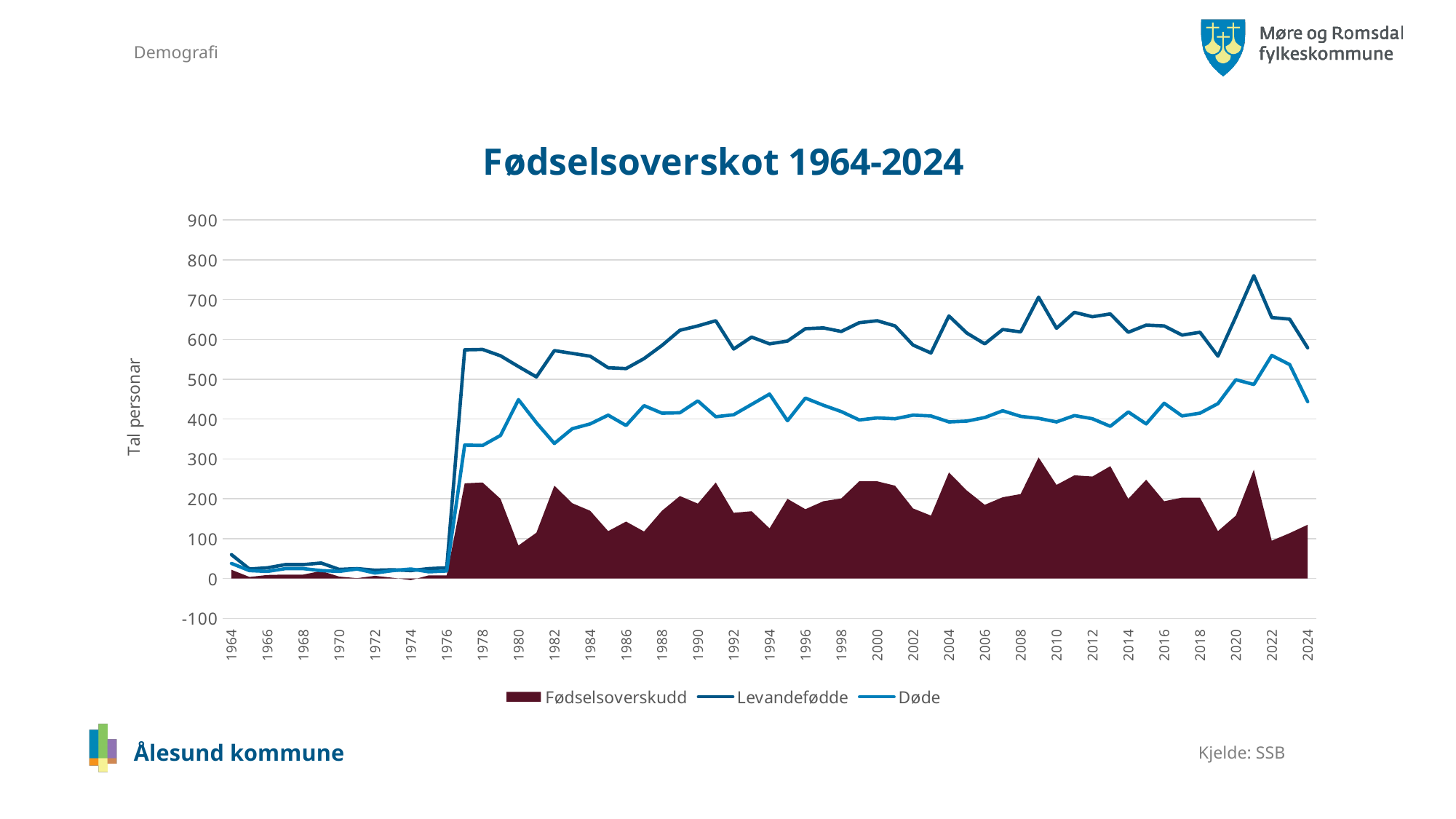
Is the value for Levandefødde in 2021 greater or less than 700? greater Is the value for Fødselsoverskudd in 2009 greater or less than 250? greater Is the value for Døde in 1964 greater or less than 100? less How many series does the legend list? 3 What is the title of the chart? Fødselsoverskot 1964-2024 In which year does Levandefødde reach its highest value? 2021 In 2000, which is larger, Levandefødde or Døde? Levandefødde Does Fødselsoverskudd rise or fall from 1976 to 1977? rise What kind of chart is this? line and area chart Does Levandefødde rise or fall from 2021 to 2024? fall What is the label on the vertical axis? Tal personar